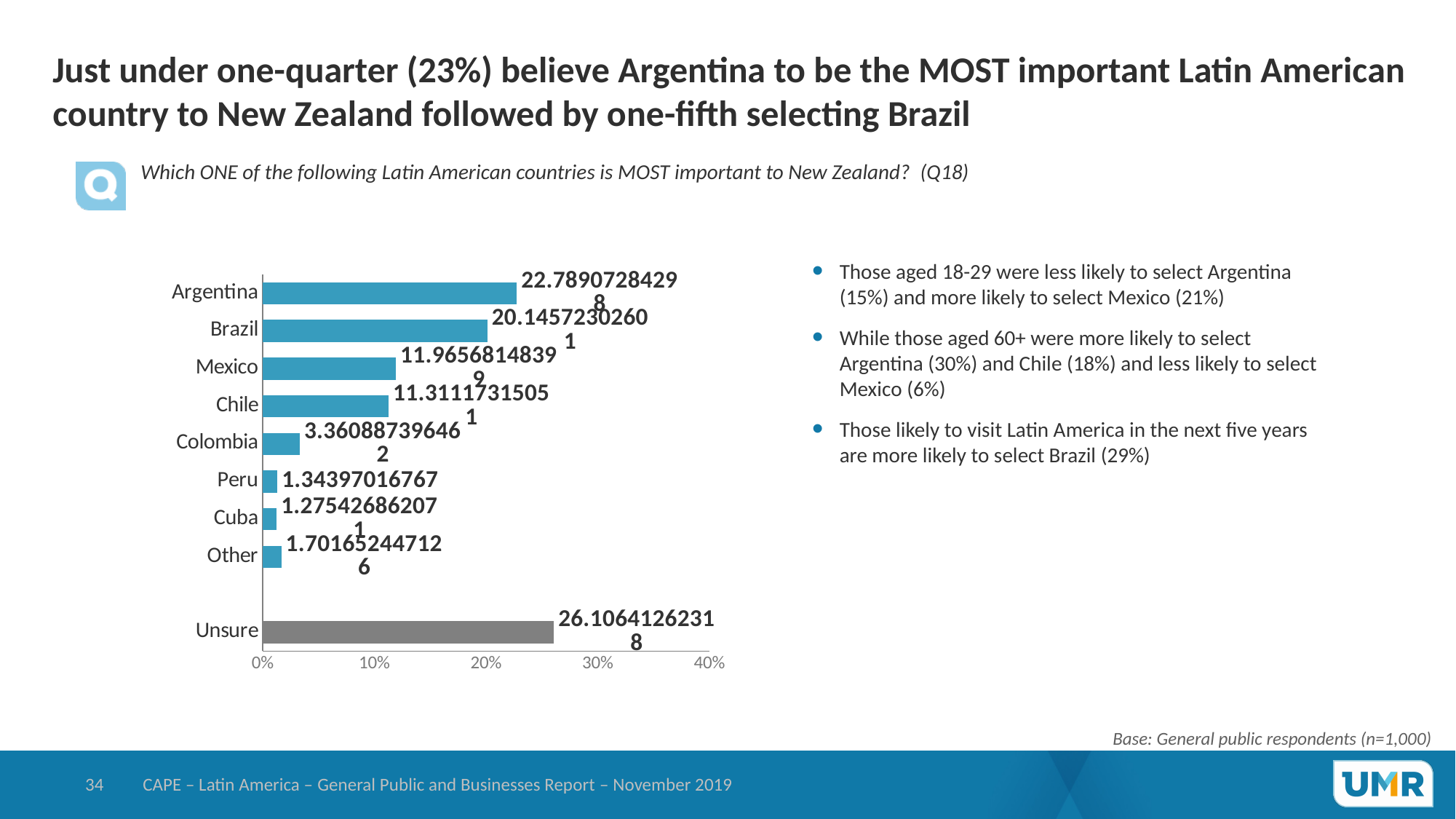
Which country has the highest value in the chart? Argentina Which category has the lowest value in the chart? Cuba Is the value for Colombia greater or less than 10%? less What is the value shown for Argentina? 22.78907284298 What is the value shown for Peru? 1.34397016767 Which is larger, the value for Mexico or the value for Chile? Mexico What kind of chart is shown on the slide? bar chart Is the value for Argentina greater or less than 20%? greater Is the value for Unsure greater or less than 20%? greater How many categories are plotted in the chart? 9 Which category has the longest bar in the chart? Unsure What is the highest value shown on the horizontal axis of the chart? 40%